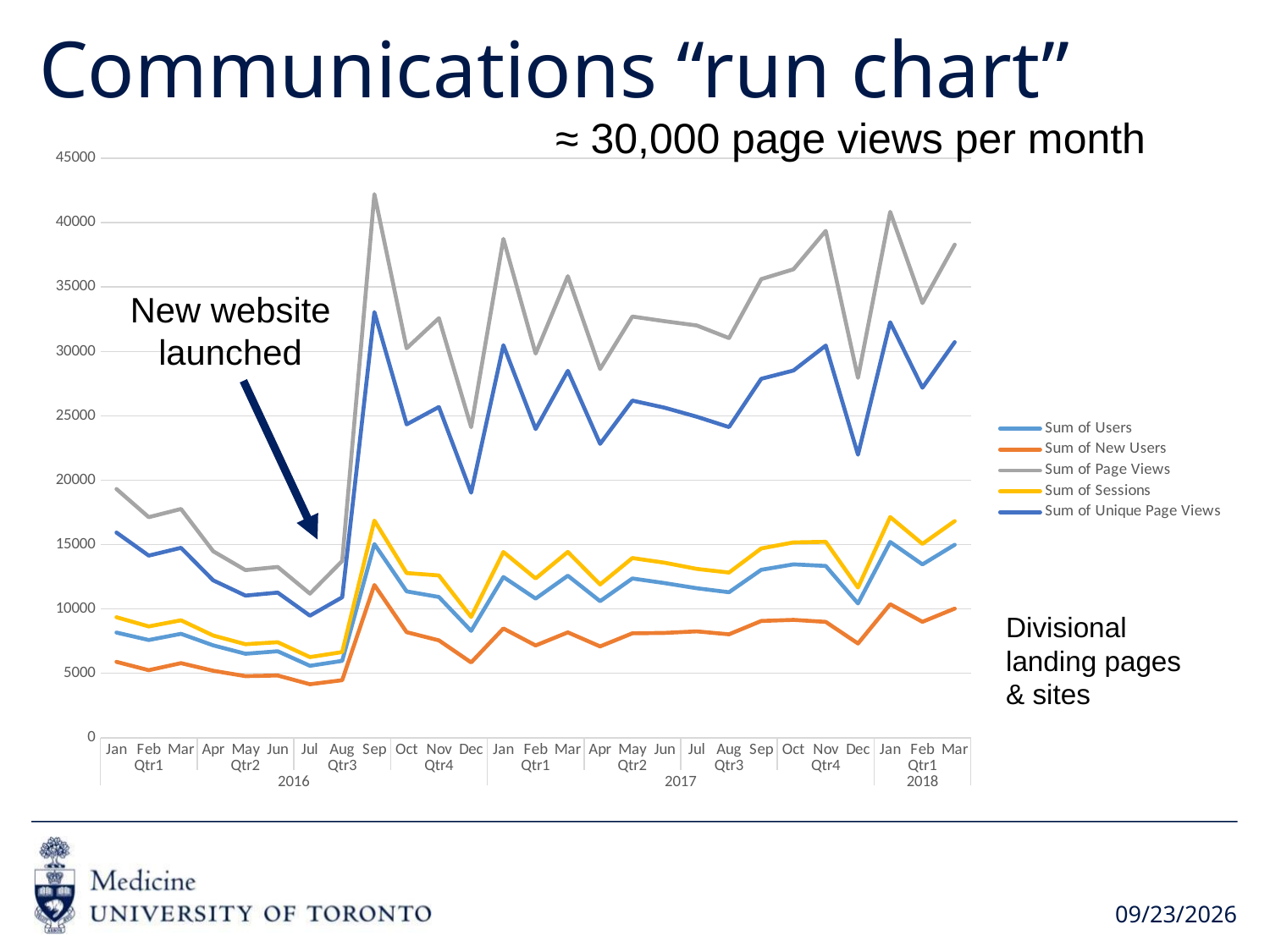
How many monthly data points are plotted along the x axis? 27 What is the title of the slide containing the chart? Communications "run chart" Is the value for Sum of New Users in Jul 2016 greater or less than 5000? less In which month does Sum of Page Views reach its highest value? Sep 2016 Is the value for Sum of Page Views in Sep 2016 greater or less than 40000? greater Is the value for Sum of Unique Page Views in Sep 2016 greater or less than 30000? greater In which month is Sum of Page Views at its lowest? Jul 2016 What kind of chart is shown on the slide? Line chart How many series does the legend list? 5 Does Sum of Page Views rise or fall from Jul 2016 to Sep 2016? Rise In Jan 2018, which is larger: Sum of Page Views or Sum of Users? Sum of Page Views